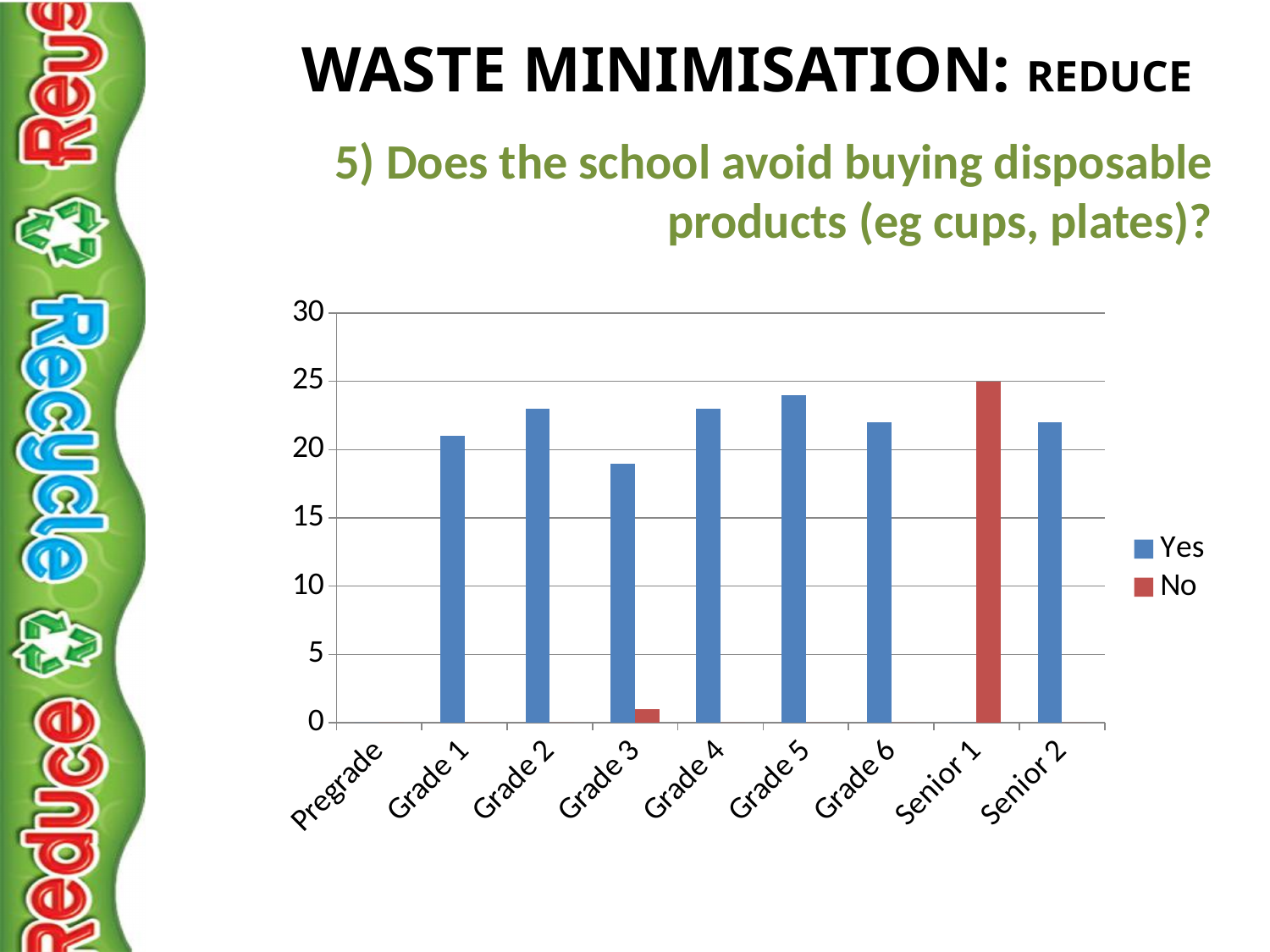
Which is larger, the Yes value for Grade 1 or the Yes value for Grade 3? Grade 1 Is the Yes value for Grade 1 greater or less than 20? greater What colour represents the No series in the legend? red Which category has a No bar but no Yes bar? Senior 1 How many categories are shown on the x axis? 9 Is the Yes value for Grade 5 greater or less than 25? less Is the Yes value for Grade 3 greater or less than 20? less For Grade 3, which is larger, the Yes bar or the No bar? Yes What is the value of the No bar for Senior 1? 25 What kind of chart is shown on the slide? bar chart How many series does the legend list? 2 Which category has the lowest Yes bar among those with a Yes bar? Grade 3